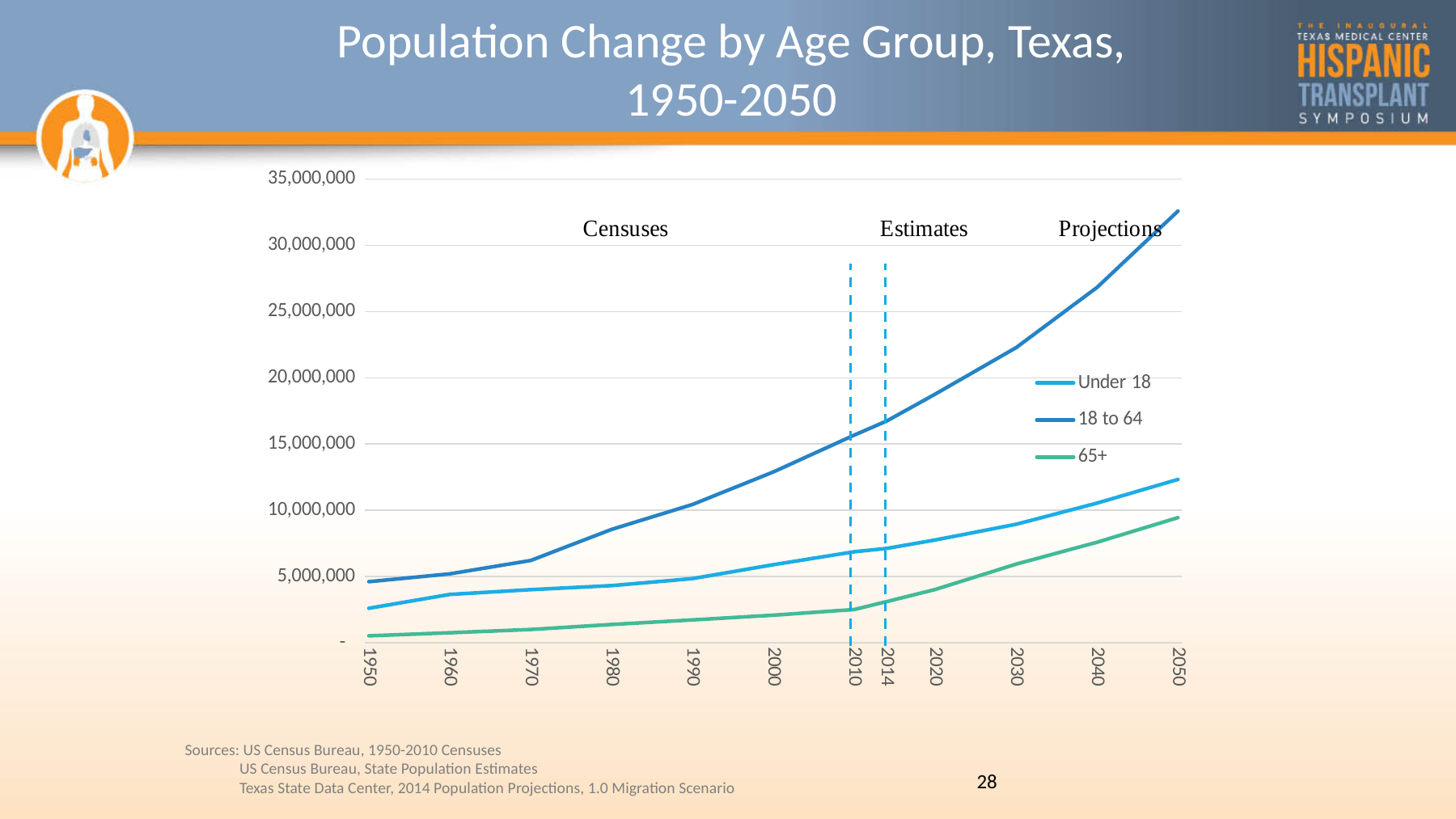
Which age group has the lowest population in 1950? 65+ Which age group has the highest population in 2050? 18 to 64 Is the value for 18 to 64 in 2000 greater or less than 15,000,000? less Is the value for 18 to 64 in 2050 greater or less than 30,000,000? greater Is the value for 65+ in 1950 greater or less than 5,000,000? less What is the title of the chart? Population Change by Age Group, Texas, 1950-2050 What type of chart is shown on the slide? Line chart In 2010, which is larger: the Under 18 population or the 65+ population? Under 18 How many series does the legend list? 3 How many years are labelled along the x axis? 12 Does the 18 to 64 population rise or fall from 1950 to 2050? Rise